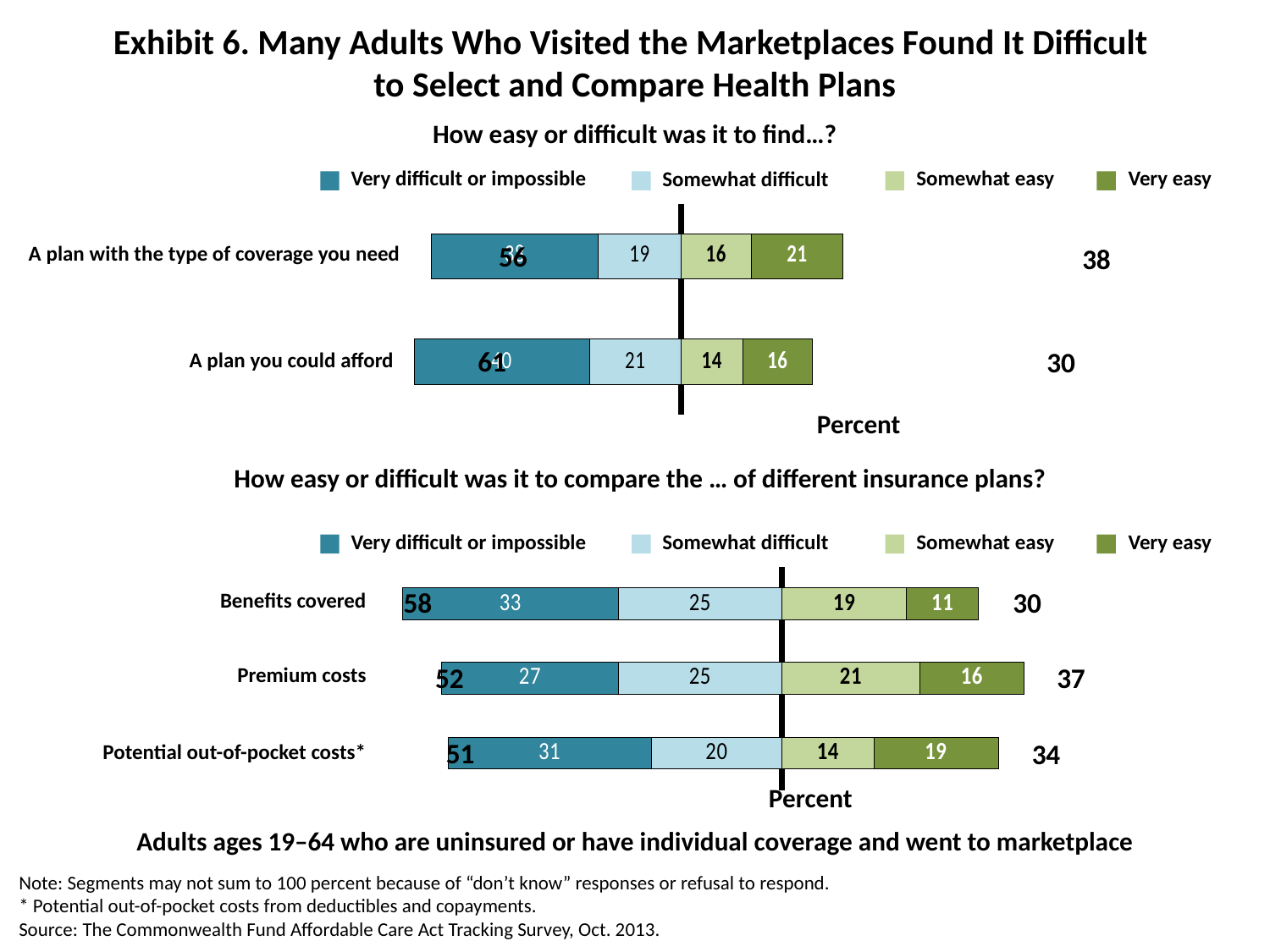
In the top chart ("How easy or difficult was it to find...?"), what is the value for "Somewhat easy" for "A plan you could afford"? 14 In the top chart ("How easy or difficult was it to find...?"), what is the value for "Very easy" for "A plan with the type of coverage you need"? 21 What kind of chart is the bottom chart ("How easy or difficult was it to compare the ... of different insurance plans?")? Stacked bar chart In the bottom chart ("How easy or difficult was it to compare the ... of different insurance plans?"), which is larger: the "Somewhat difficult" value for "Benefits covered" or for "Potential out-of-pocket costs*"? Benefits covered In the top chart ("How easy or difficult was it to find...?"), how many series does the legend list? 4 In the bottom chart ("How easy or difficult was it to compare the ... of different insurance plans?"), what is the value for "Very difficult or impossible" for "Benefits covered"? 33 In the top chart ("How easy or difficult was it to find...?"), what is the value for "Somewhat difficult" for "A plan you could afford"? 21 In the bottom chart ("How easy or difficult was it to compare the ... of different insurance plans?"), which category has the lowest "Very easy" value? Benefits covered In the bottom chart ("How easy or difficult was it to compare the ... of different insurance plans?"), which category has the highest "Very difficult or impossible" value? Benefits covered In the bottom chart ("How easy or difficult was it to compare the ... of different insurance plans?"), what is the difference between the "Somewhat easy" values for "Premium costs" and "Potential out-of-pocket costs*"? 7 In the bottom chart ("How easy or difficult was it to compare the ... of different insurance plans?"), what is the value for "Very easy" for "Potential out-of-pocket costs*"? 19 In the top chart ("How easy or difficult was it to find...?"), how many categories are plotted? 2